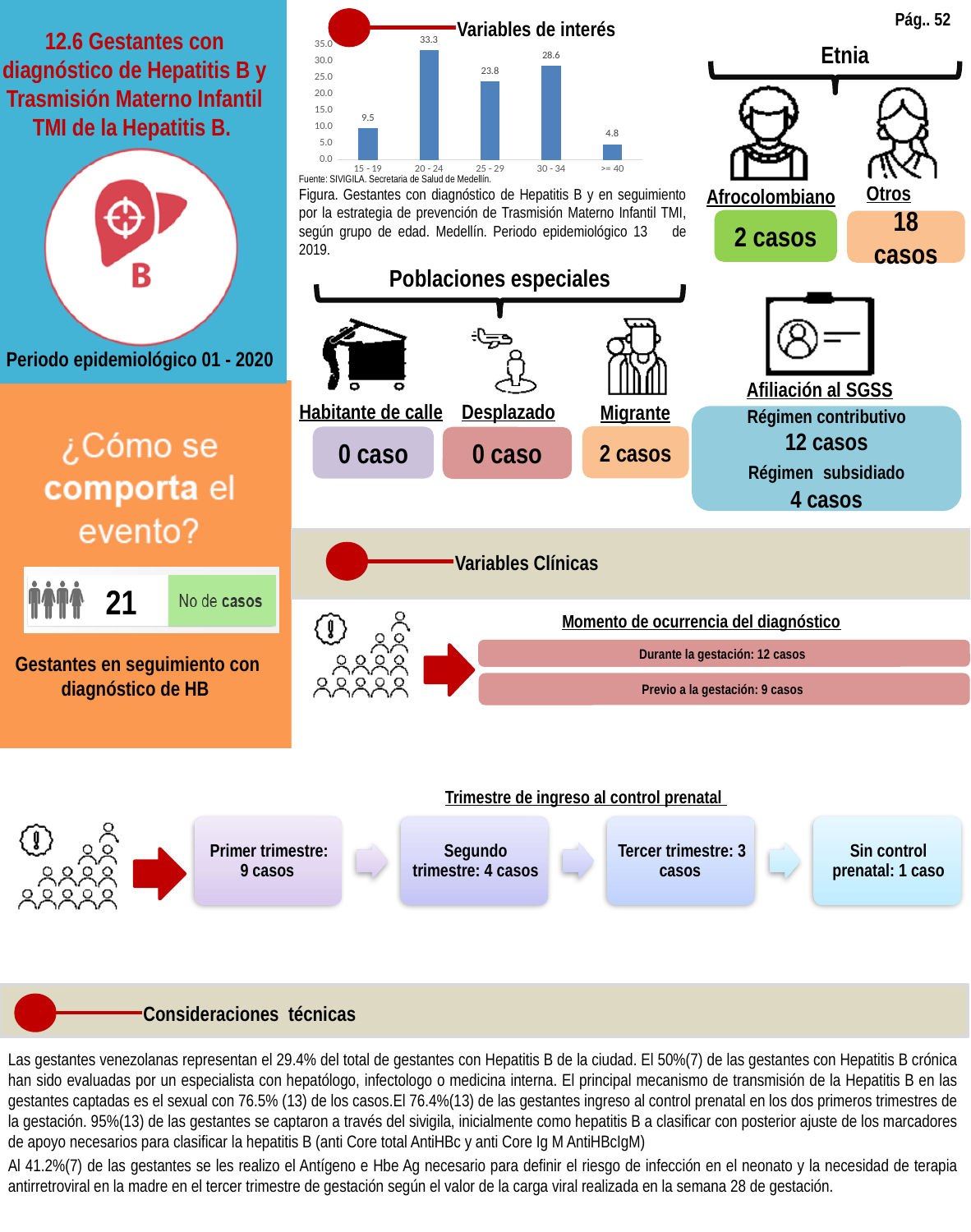
Which age group has a larger value in the bar chart, 25 - 29 or 30 - 34? 30 - 34 Which age group has the highest value in the bar chart? 20 - 24 Which age group has the lowest value in the bar chart? >= 40 What is the difference between the values for the 20 - 24 and 25 - 29 age groups in the bar chart? 9.5 What is the value for the 15 - 19 age group in the bar chart? 9.5 What is the source cited below the bar chart? SIVIGILA. Secretaria de Salud de Medellín. What is the value for the >= 40 age group in the bar chart? 4.8 How many age groups are shown in the bar chart? 5 What is the value for the 20 - 24 age group in the bar chart? 33.3 What kind of chart is used to show the distribution by age group? bar chart What is the value for the 30 - 34 age group in the bar chart? 28.6 Is the value for the 15 - 19 age group in the bar chart greater or less than 10.0? less